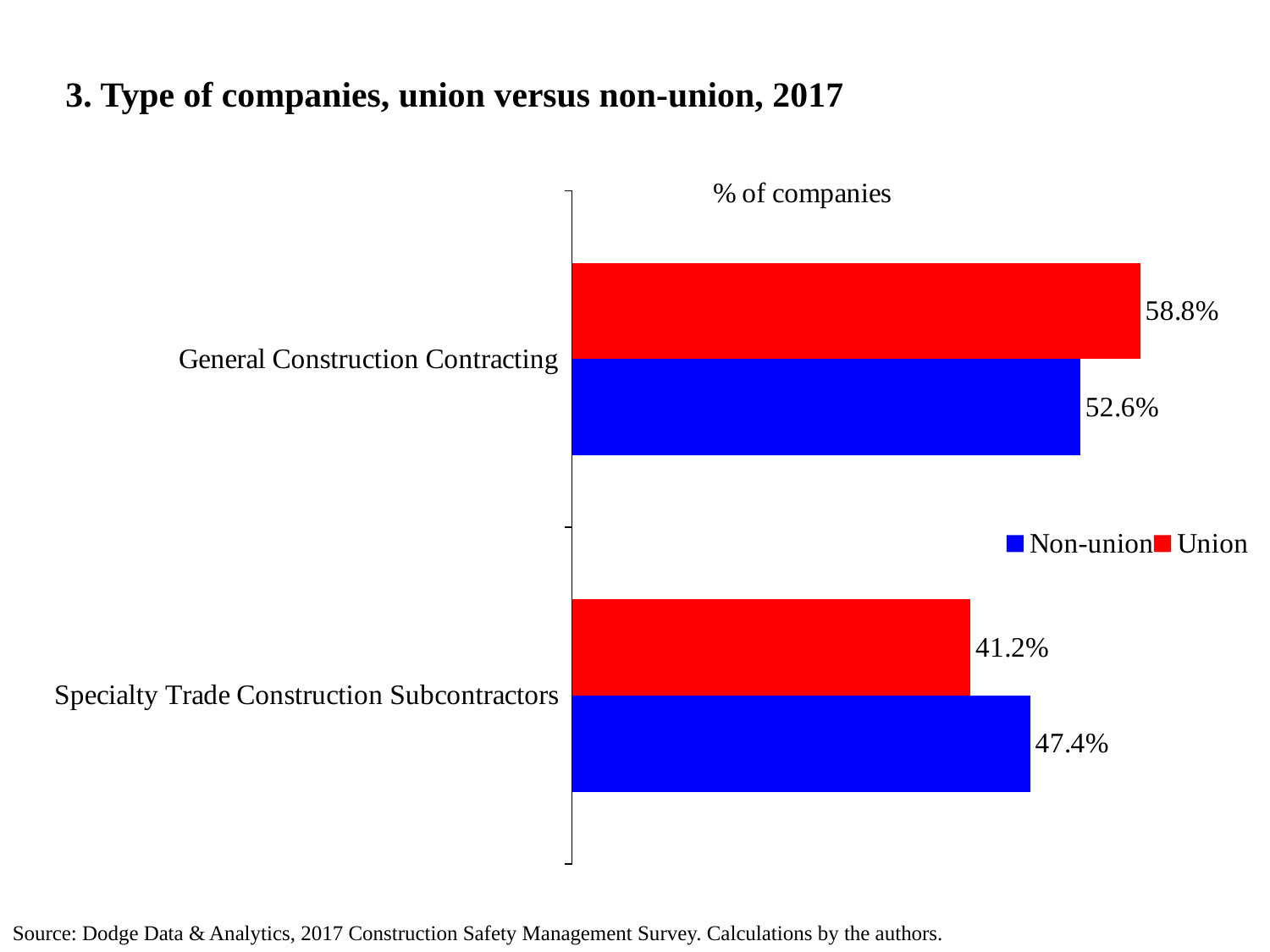
What percentage of Non-union companies are Specialty Trade Construction Subcontractors? 47.4% What percentage of Union companies are General Construction Contracting? 58.8% Which category has the lowest value for the Non-union series? Specialty Trade Construction Subcontractors How many series does the legend list? 2 For Specialty Trade Construction Subcontractors, which is larger: the Union value or the Non-union value? Non-union What is the difference between the Union and Non-union values for General Construction Contracting? 6.2% Which category has the highest value for the Union series? General Construction Contracting What is the difference between the Non-union and Union values for Specialty Trade Construction Subcontractors? 6.2% What kind of chart is shown on the slide? Bar chart How many categories are shown on the chart? 2 What percentage of Union companies are Specialty Trade Construction Subcontractors? 41.2% What percentage of Non-union companies are General Construction Contracting? 52.6%